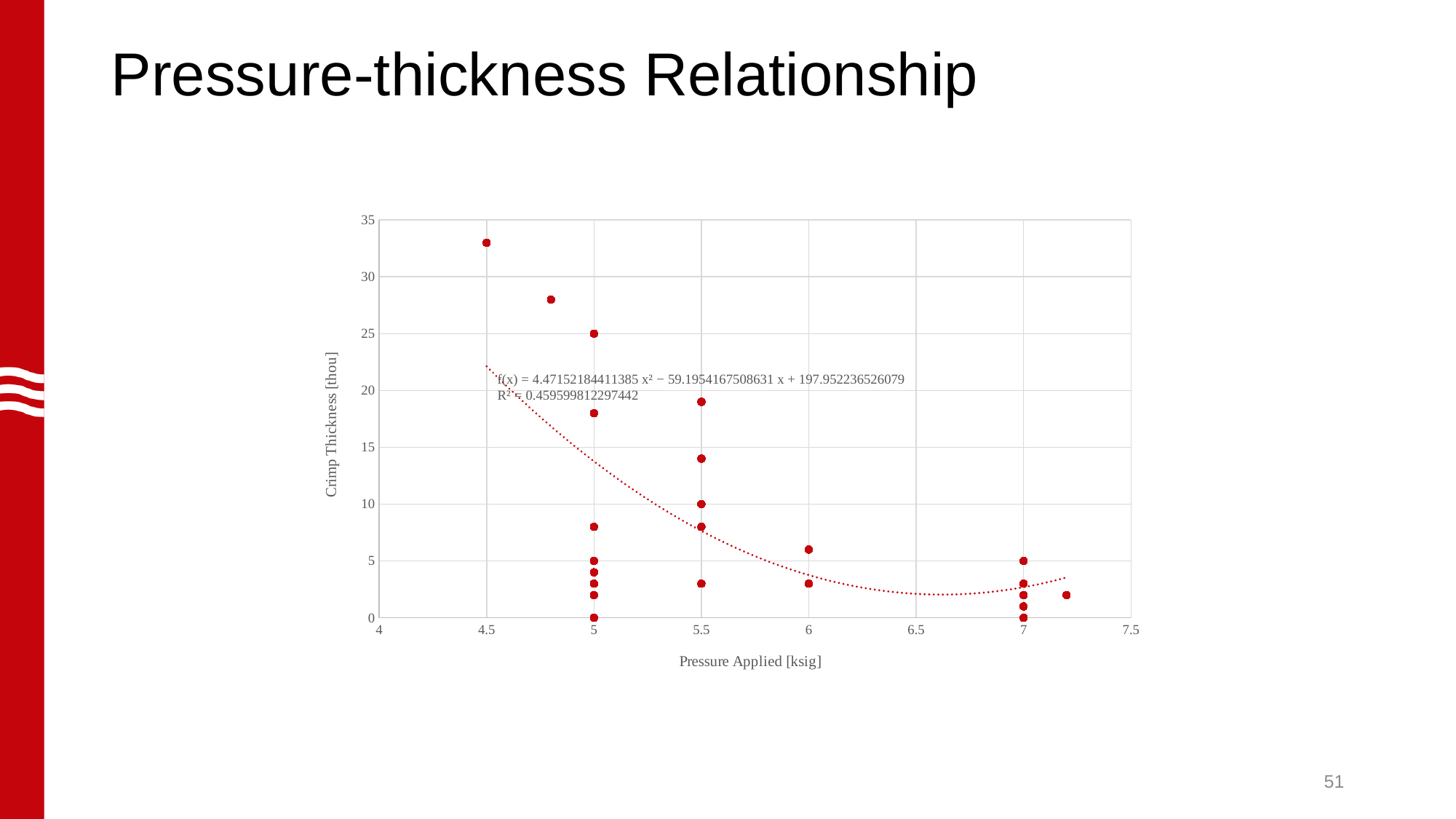
Is the crimp thickness of the point at pressure 7.2 greater or less than 5? less What is the lowest pressure value at which a point is plotted? 4.5 At which pressure value is the highest crimp thickness recorded? 4.5 Is the crimp thickness of the point at pressure 4.8 greater or less than 25? greater What kind of chart is shown on the slide? scatter chart Which has the higher crimp thickness: the point at pressure 4.5 or the point at pressure 4.8? 4.5 Is the highest crimp thickness at pressure 6 greater or less than 10? less Overall, does crimp thickness rise or fall as pressure applied increases? fall What is the title of the chart on the slide? Pressure-thickness Relationship What is the label of the y axis? Crimp Thickness [thou]